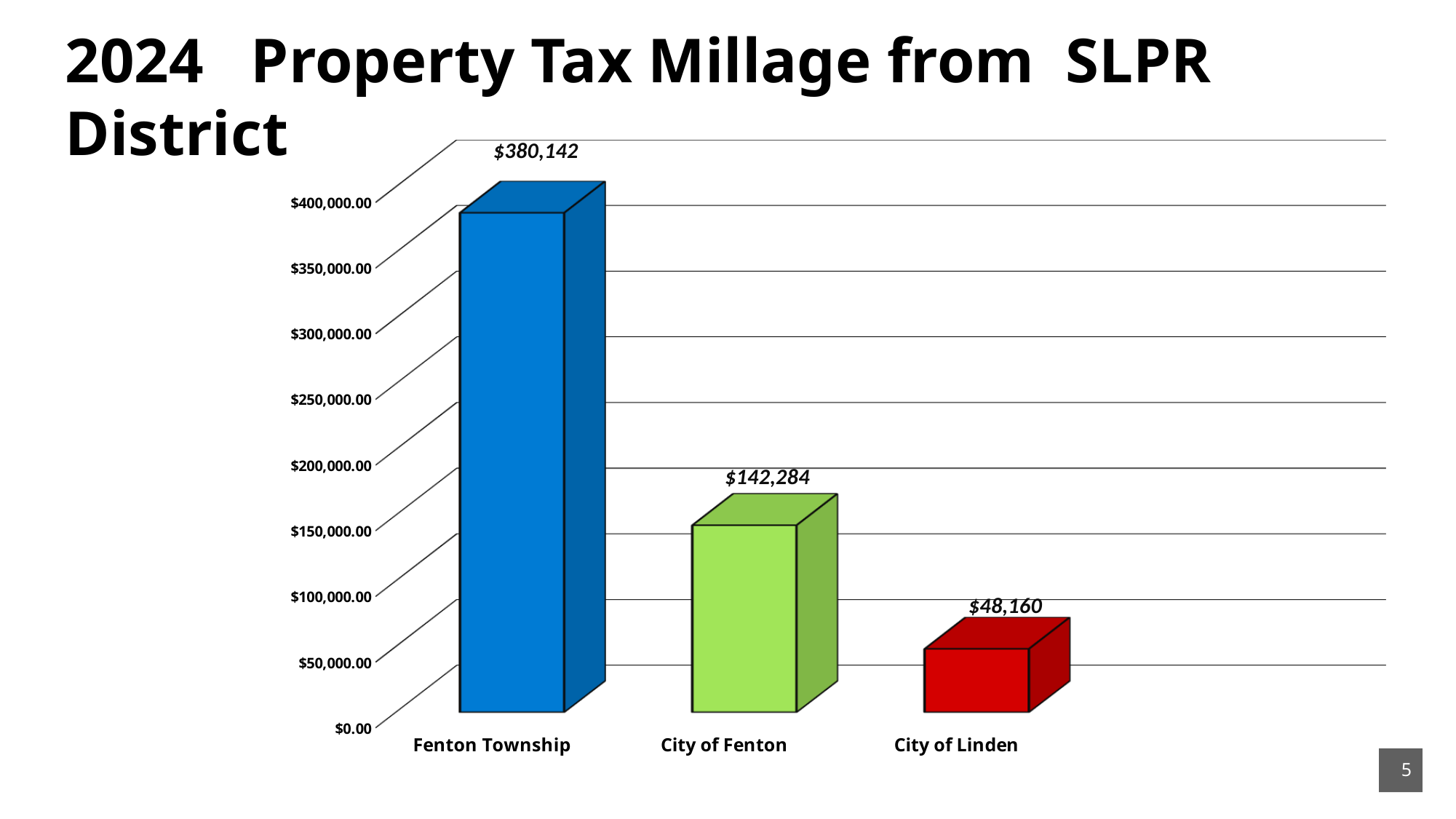
Which category has the highest value? Fenton Township Is the value for City of Linden greater or less than $50,000.00? less What is the value for City of Fenton? $142,284 What is the value for Fenton Township? $380,142 Which category has the lowest value? City of Linden What is the difference between the values for City of Fenton and City of Linden? $94,124 What colour is the bar for City of Linden? red What is the value for City of Linden? $48,160 What kind of chart is shown on the slide? bar chart How many categories are shown in the chart? 3 Which is larger, the value for City of Fenton or the value for City of Linden? City of Fenton What is the difference between the values for Fenton Township and City of Fenton? $237,858